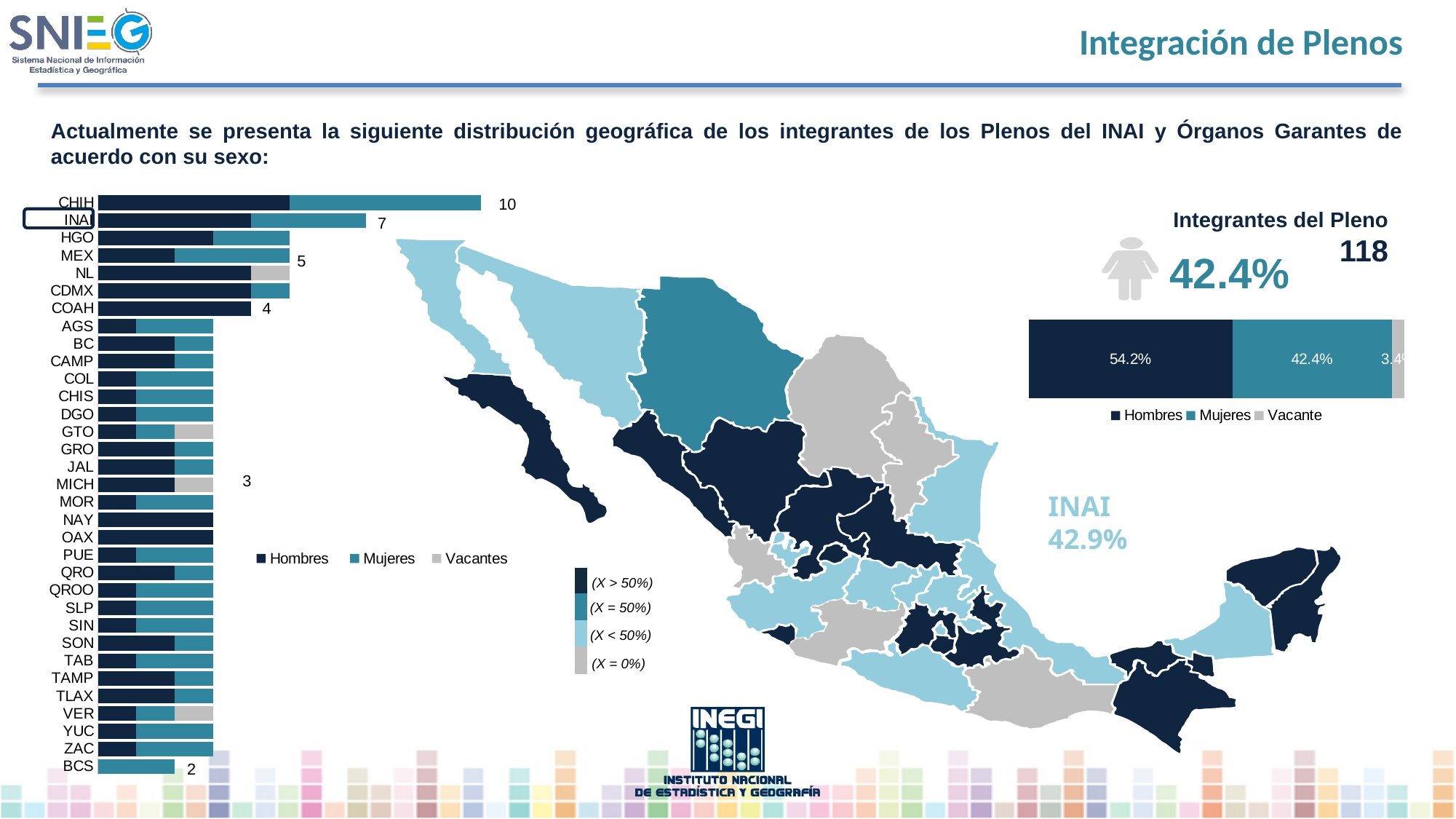
In the left bar chart, how many series does the legend list? 3 In the left bar chart, which has a larger total, CHIH or BCS? CHIH What total number of 'Integrantes del Pleno' is shown on the right side of the slide? 118 In the left bar chart, which entity has the lowest total number of members? BCS In the left bar chart, what is the total number of members shown for COAH? 4 In the left bar chart, what is the total number of members shown for INAI? 7 In the stacked bar on the right under 'Integrantes del Pleno', what percentage is shown for Hombres? 54.2% What kind of chart is the chart on the left of the slide listing CHIH, INAI, HGO and other entities? bar chart In the left bar chart, which entity has the highest total number of members? CHIH In the left bar chart, how many categories (entities) are plotted? 33 In the left bar chart, what is the difference between the total for CHIH and the total for INAI? 3 In the stacked bar on the right under 'Integrantes del Pleno', what percentage is shown for Mujeres? 42.4%